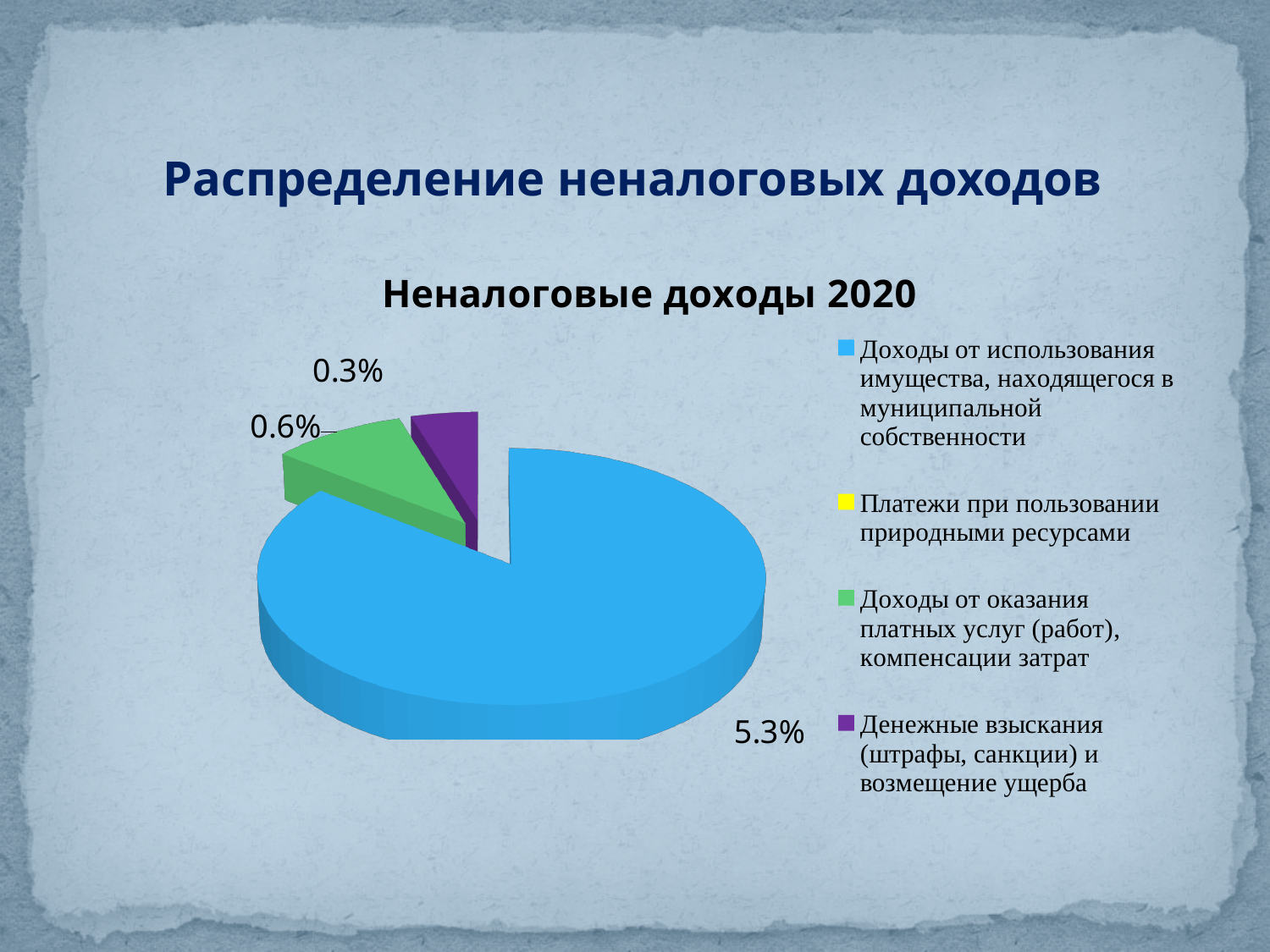
What value is labelled on the slice for "Денежные взыскания (штрафы, санкции) и возмещение ущерба"? 0.3% What is the title of the chart? Неналоговые доходы 2020 What is the difference between the labelled values for "Доходы от использования имущества" (5.3%) and "Доходы от оказания платных услуг" (0.6%)? 4.7% What kind of chart is shown on the slide? Pie chart What value is labelled on the slice for "Доходы от оказания платных услуг (работ), компенсации затрат"? 0.6% What is the difference between the labelled values for "Доходы от оказания платных услуг" (0.6%) and "Денежные взыскания" (0.3%)? 0.3% Which category has the largest slice of the pie? Доходы от использования имущества, находящегося в муниципальной собственности What value is labelled on the slice for "Доходы от использования имущества, находящегося в муниципальной собственности"? 5.3% How many entries does the chart legend list? 4 How many data labels are printed on the pie chart? 3 What colour is the largest slice of the pie? Blue Which is larger: the slice for "Доходы от оказания платных услуг (работ), компенсации затрат" or the slice for "Денежные взыскания (штрафы, санкции) и возмещение ущерба"? Доходы от оказания платных услуг (работ), компенсации затрат